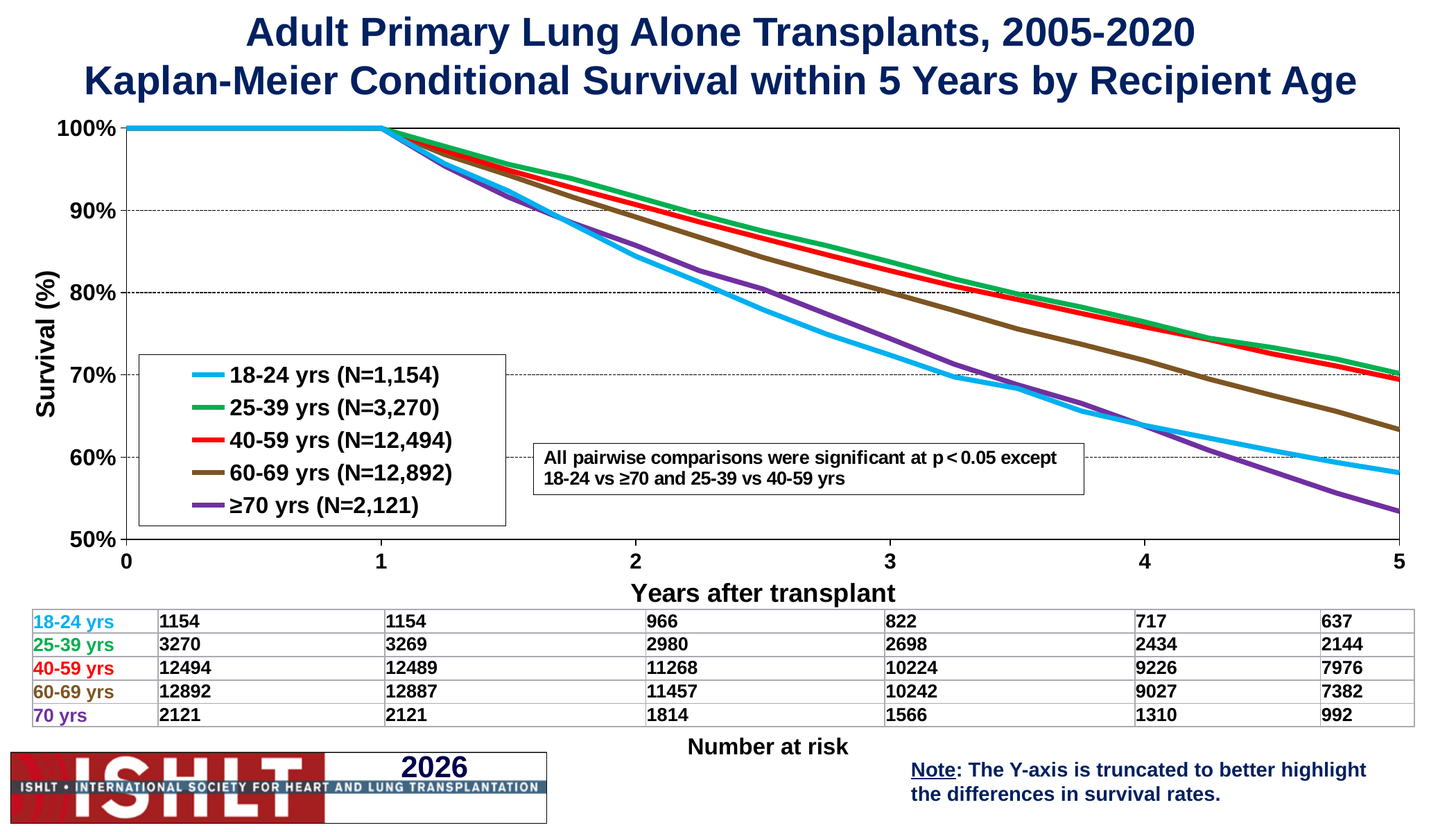
What is the difference between the number at risk for the 40-59 yrs group at year 0 and at year 5? 4518 Which recipient age group has the lowest survival at 5 years after transplant? ≥70 yrs How many recipient age groups does the legend list? 5 According to the number at risk table, how many 18-24 yrs recipients were at risk at year 5? 637 What kind of chart is shown on the slide? Line chart Is the survival for the 18-24 yrs group at 3 years greater or less than 70%? greater What is the N for the 40-59 yrs group shown in the legend? N=12,494 Is the survival for the 60-69 yrs group at 5 years greater or less than 60%? greater Which two pairwise comparisons were not significant at p < 0.05 according to the text box? 18-24 vs ≥70 and 25-39 vs 40-59 yrs Do the survival curves rise or fall as years after transplant increase? Fall According to the number at risk table, how many 60-69 yrs recipients were at risk at year 2? 11457 Is the survival for the ≥70 yrs group at 5 years greater or less than 60%? less